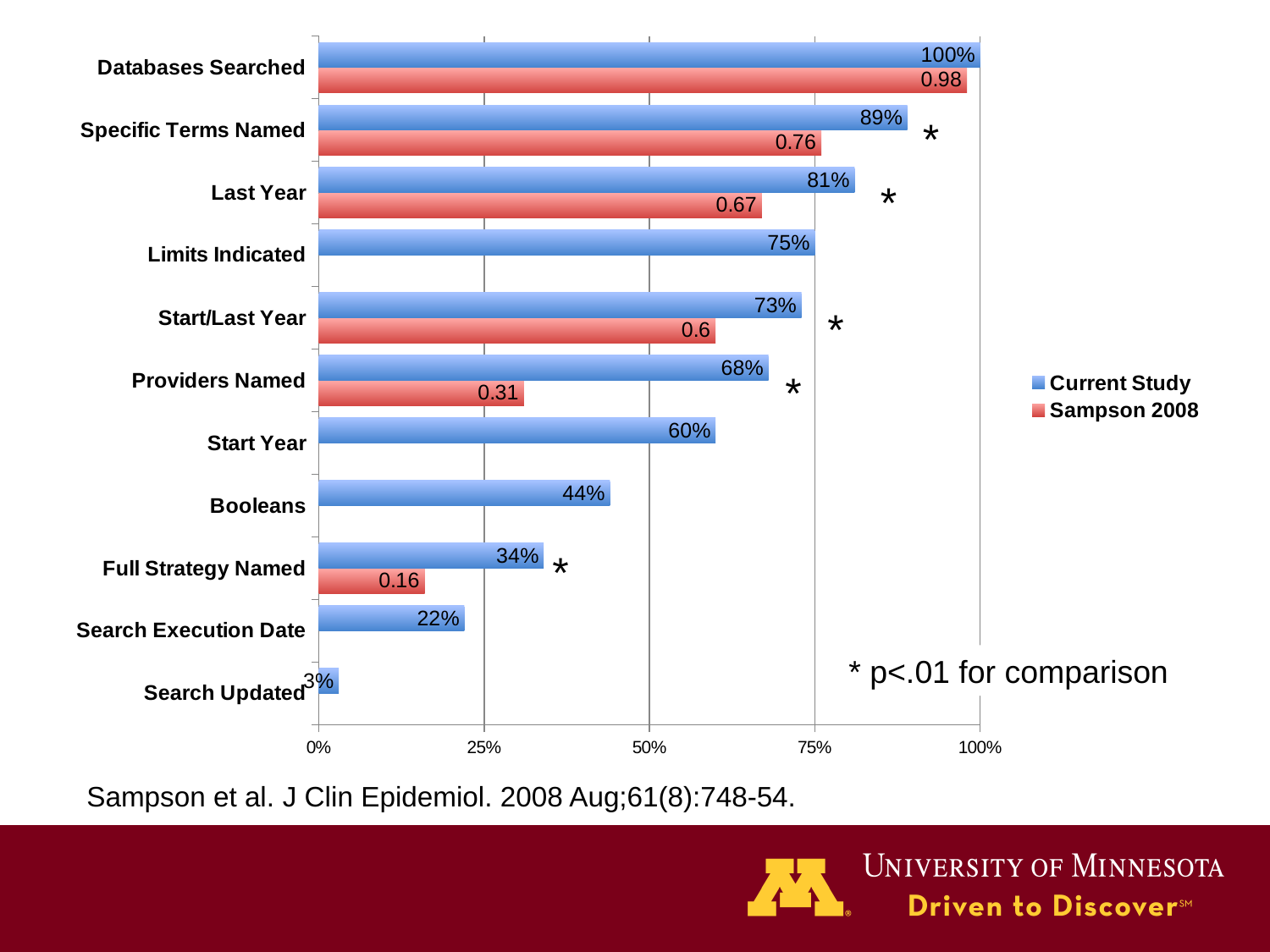
Which category has the lowest Current Study value? Search Updated What is the Current Study value for Specific Terms Named? 89% What is the Current Study value for Search Execution Date? 22% Which is larger, the Current Study value for Booleans or the Current Study value for Full Strategy Named? Booleans Which category has the highest Current Study value? Databases Searched How many series does the legend list? 2 What is the Sampson 2008 value for Full Strategy Named? 0.16 How many categories are shown on the chart? 11 What kind of chart is shown on the slide? Bar chart What is the Sampson 2008 value for Providers Named? 0.31 What is the difference between the Current Study values for Limits Indicated and Start Year? 15% Which category has the lowest Sampson 2008 value? Full Strategy Named